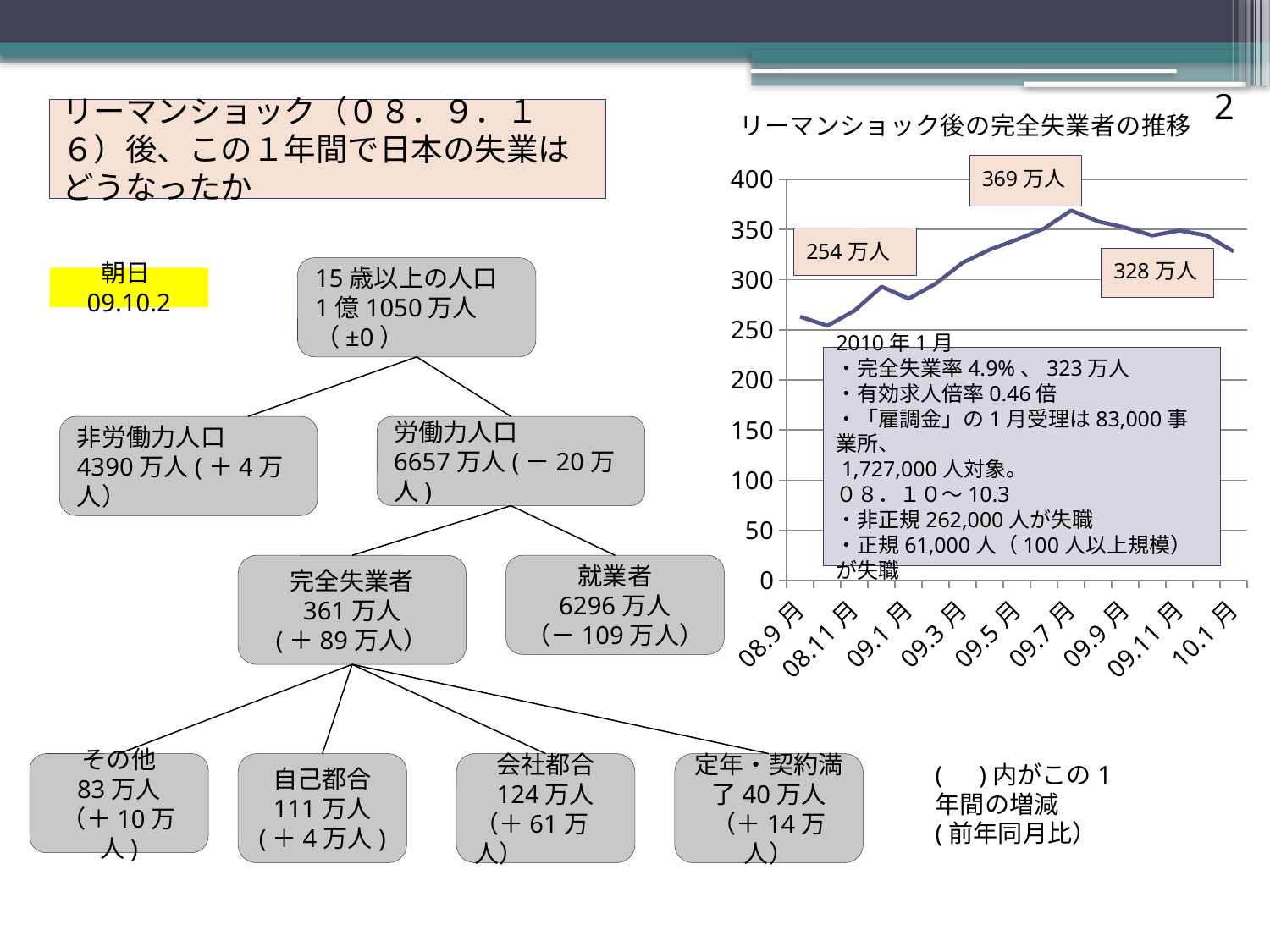
In the chart リーマンショック後の完全失業者の推移, is the value for 09.5月 greater or less than 300? greater In the chart リーマンショック後の完全失業者の推移, which is larger, the value at 09.7月 or the value at 10.1月? 09.7月 What is the title of the chart on the right side of the slide? リーマンショック後の完全失業者の推移 In the chart リーマンショック後の完全失業者の推移, what is the value labelled at 10.1月? 328万人 In the chart リーマンショック後の完全失業者の推移, what is the peak value labelled on the line? 369万人 In the chart リーマンショック後の完全失業者の推移, what is the lowest value labelled on the line? 254万人 In the chart リーマンショック後の完全失業者の推移, does the line generally rise or fall from 08.9月 to 09.7月? rise In the chart リーマンショック後の完全失業者の推移, is the value for 08.9月 greater or less than 300? less In the chart リーマンショック後の完全失業者の推移, at which month does the line reach its highest point? 09.7月 In the chart リーマンショック後の完全失業者の推移, what is the difference between the labelled peak value and the labelled lowest value? 115万人 What kind of chart is shown on the right side of the slide? line chart In the chart リーマンショック後の完全失業者の推移, how much lower is the labelled value at 10.1月 than the labelled peak value? 41万人